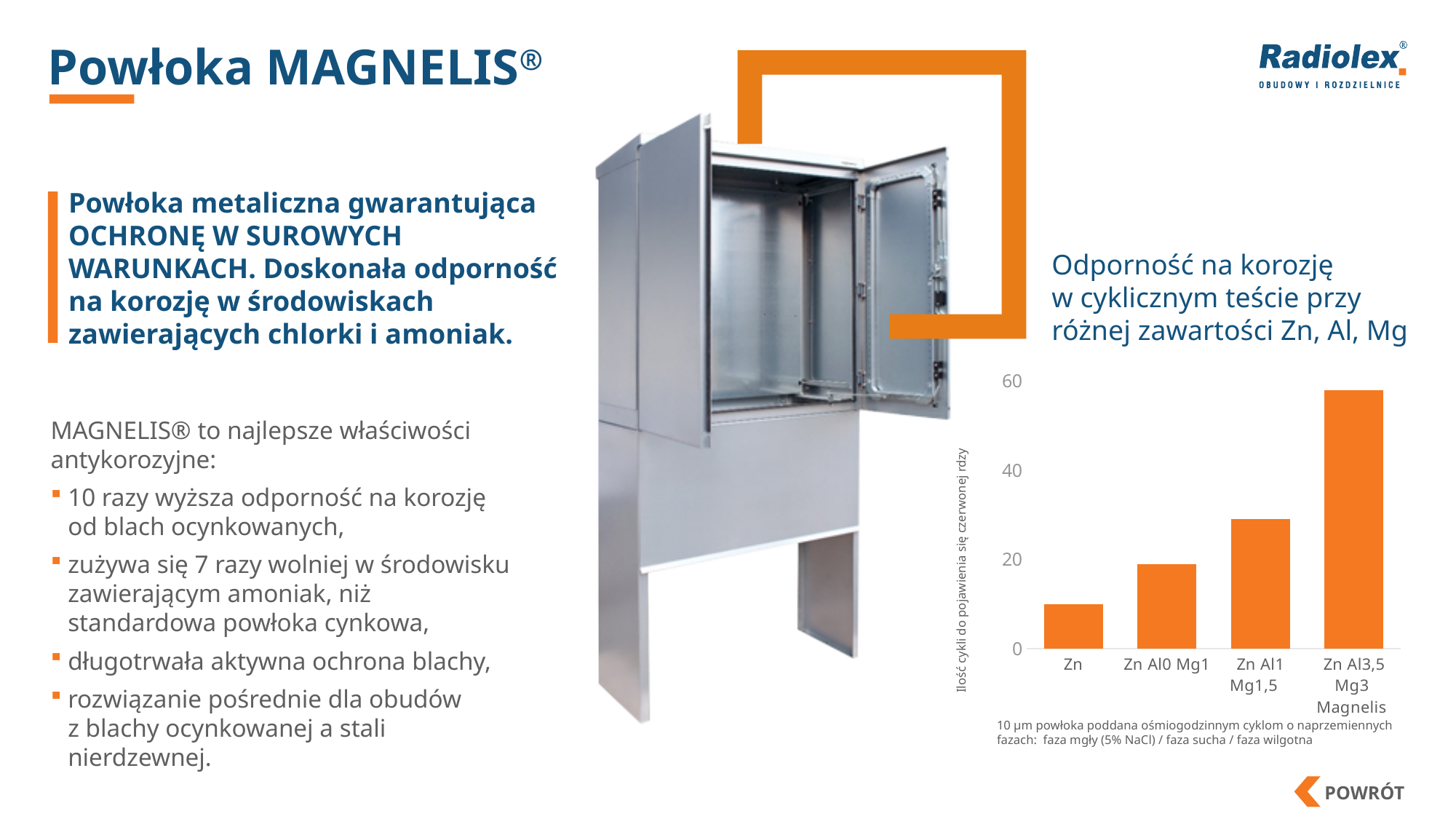
What is the title of the chart? Odporność na korozję w cyklicznym teście przy różnej zawartości Zn, Al, Mg Which category has the highest bar in the chart? Zn Al3,5 Mg3 Magnelis What is the label of the vertical axis of the chart? Ilość cykli do pojawienia się czerwonej rdzy Is the value for Zn Al1 Mg1,5 greater or less than 20? greater Is the value for Zn Al3,5 Mg3 Magnelis greater or less than 40? greater Is the value for Zn Al1 Mg1,5 greater or less than 40? less Which category has the lowest bar in the chart? Zn Which is larger, the value for Zn Al0 Mg1 or the value for Zn Al1 Mg1,5? Zn Al1 Mg1,5 What kind of chart is shown on the slide? bar chart How many categories are plotted in the bar chart? 4 Do the bar values rise or fall from left to right along the x axis? rise